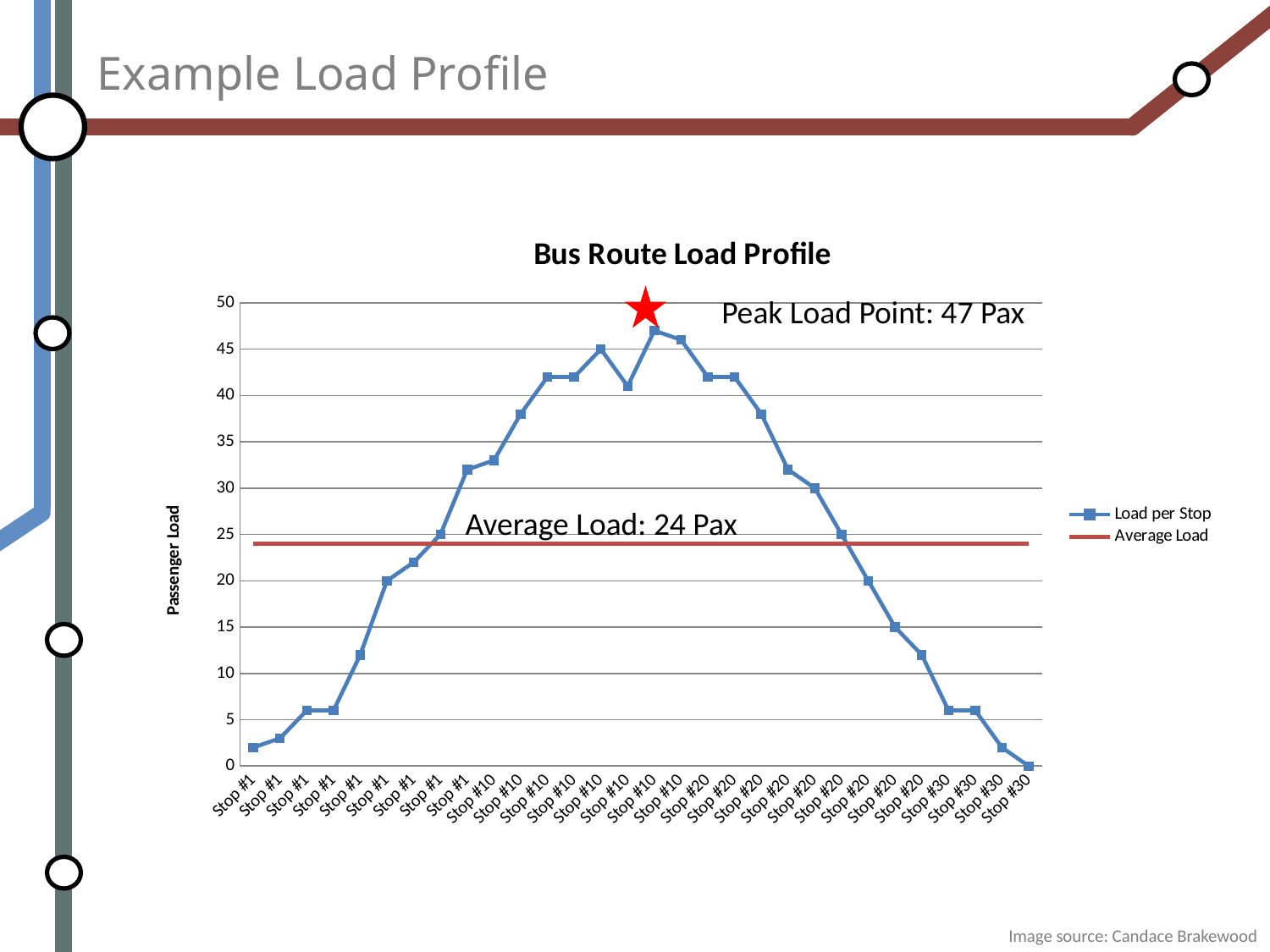
Is the value for the first stop on the x axis greater or less than 5? less Does the Load per Stop series rise or fall from the peak load point to the last stop? fall What is the peak load point value shown on the chart? 47 Pax What type of chart is shown on the slide? Line chart What is the difference between the peak load point and the average load? 23 Pax What are the two series named in the legend? Load per Stop and Average Load What is the average load value shown on the chart? 24 Pax How many series does the legend list? 2 Does the Load per Stop series rise or fall from the first stop to the peak load point? rise Which is larger, the peak load point or the average load? Peak load point What is the passenger load at the last stop on the x axis? 0 What is the title of the chart? Bus Route Load Profile